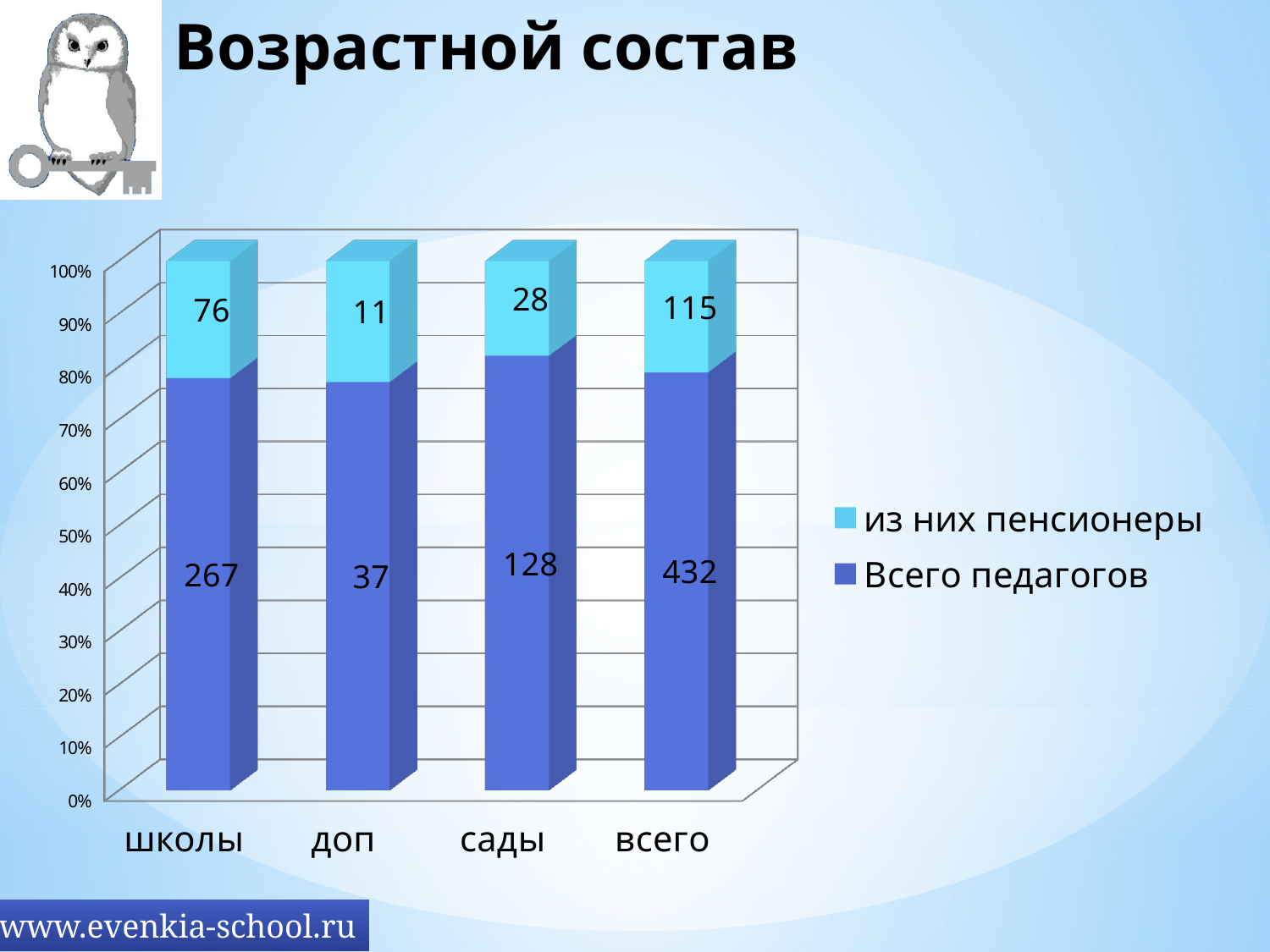
How many series does the legend list? 2 Which category has the highest value for 'из них пенсионеры'? всего How many categories are shown on the x axis? 4 What type of chart is shown on the slide? stacked bar chart What is the difference between 'Всего педагогов' for школы and for сады? 139 What is the value of 'Всего педагогов' for всего? 432 Which category has the lowest value for 'Всего педагогов'? доп What is the value of 'Всего педагогов' for школы? 267 Which is larger: 'из них пенсионеры' for школы or for сады? школы What is the value of 'из них пенсионеры' for сады? 28 Is the top of the 'Всего педагогов' segment for доп greater or less than 70%? greater What is the value of 'из них пенсионеры' for доп? 11